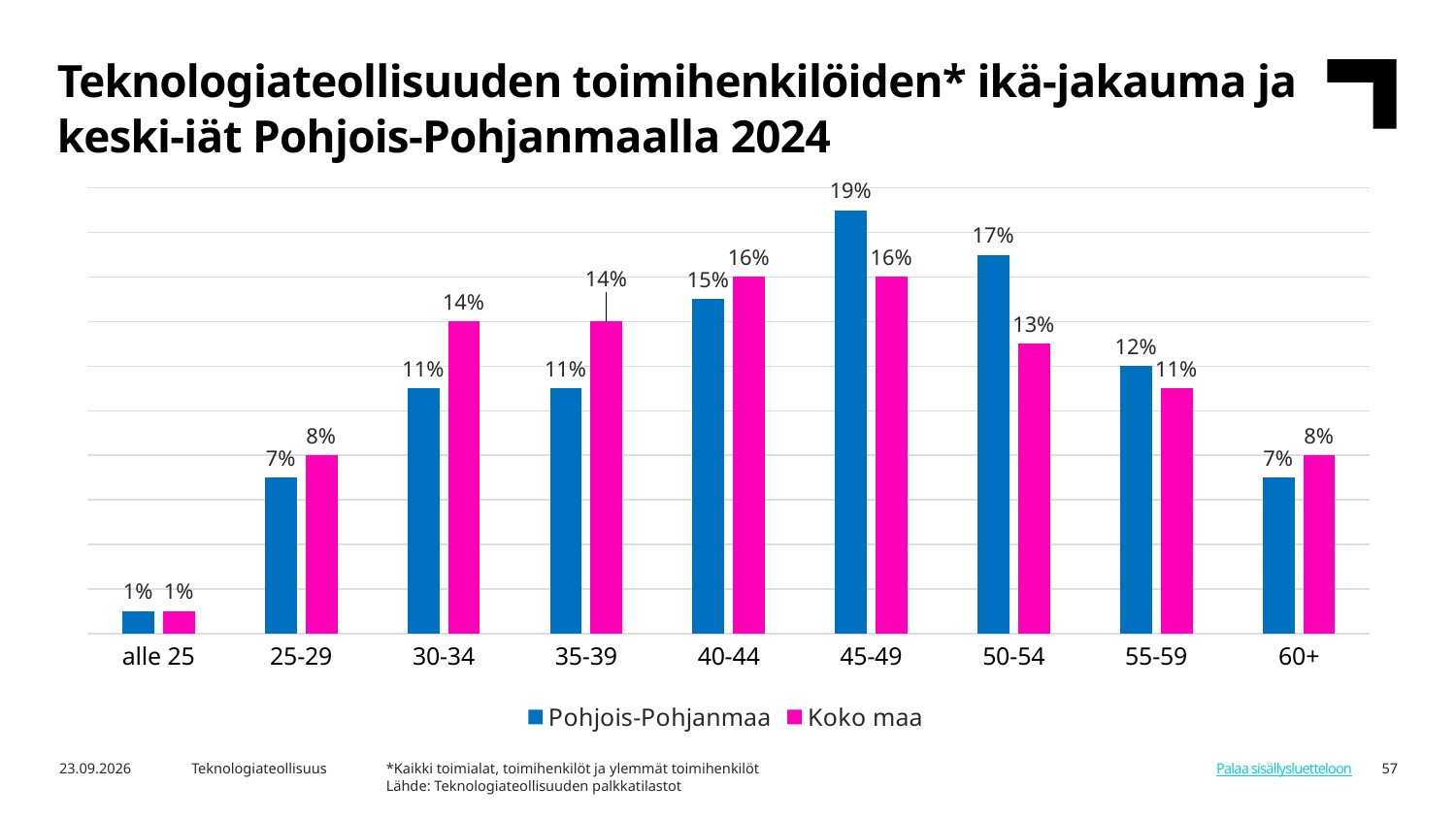
What is the difference between Pohjois-Pohjanmaa and Koko maa in the 50-54 age group? 4% How many age groups are shown on the x axis? 9 Which age group has the lowest value for Koko maa? alle 25 Which series has the larger value in the 35-39 age group, Pohjois-Pohjanmaa or Koko maa? Koko maa What kind of chart is shown on the slide? Bar chart Which colour represents Koko maa in the chart? Magenta (pink) What is the value for Pohjois-Pohjanmaa in the 45-49 age group? 19% Do the Pohjois-Pohjanmaa values rise or fall from the 45-49 age group to the 60+ age group? Fall What is the value for Koko maa in the 30-34 age group? 14% Which age group has the highest value for Pohjois-Pohjanmaa? 45-49 How many series does the legend list? 2 What is the value for Pohjois-Pohjanmaa in the 55-59 age group? 12%